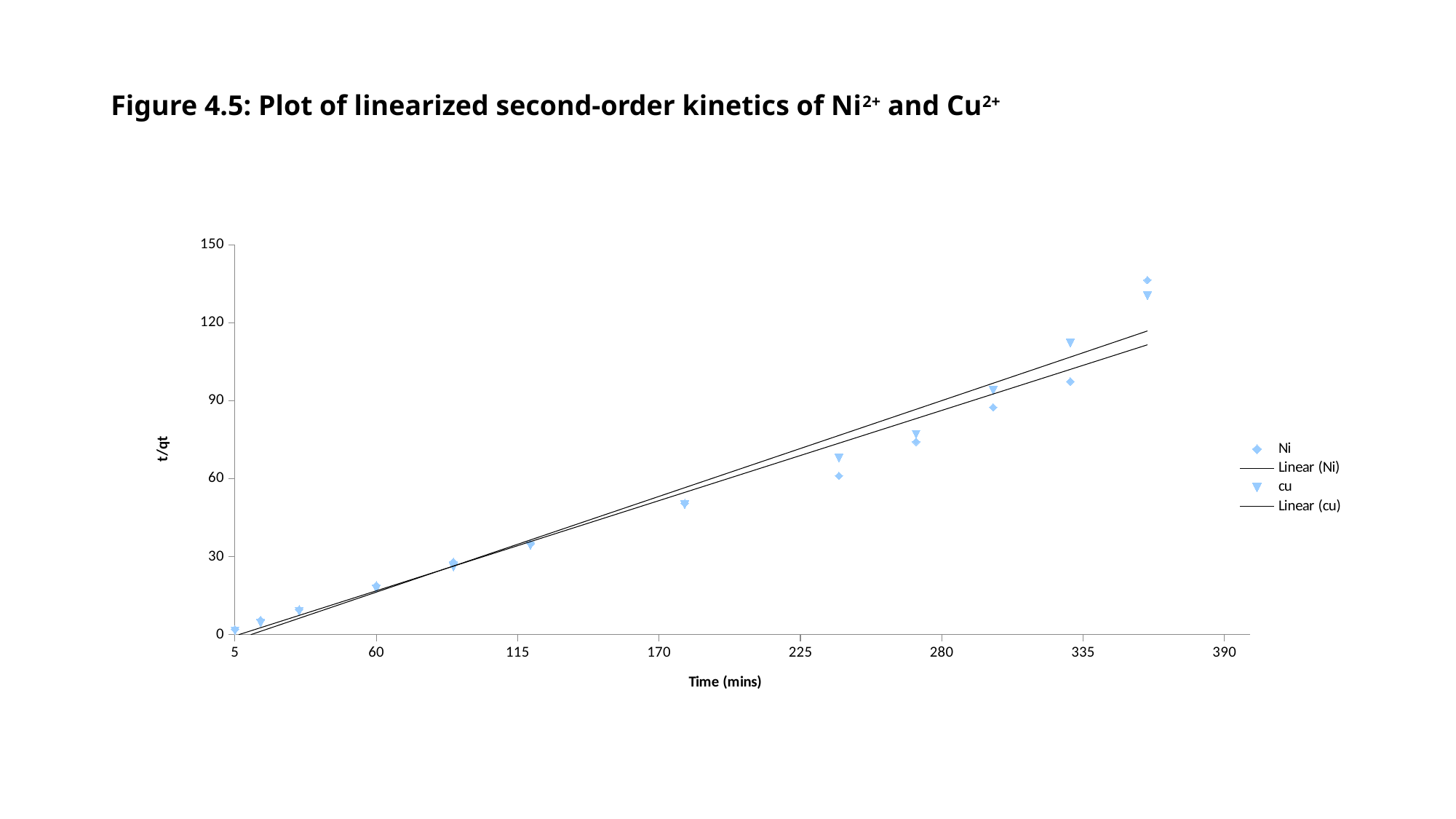
What kind of chart is shown on the slide? Scatter chart Is the cu value at around 240 mins greater or less than 60? greater Is the Ni value at the last time point (around 360 mins) greater or less than 120? greater Is the cu value at around 330 mins greater or less than 120? less What is the title of the chart on the slide? Figure 4.5: Plot of linearized second-order kinetics of Ni2+ and Cu2+ How many entries does the chart legend list? 4 Which series has the highest plotted t/qt value on the chart? Ni Do the t/qt values rise or fall as time increases? Rise At around 330 mins, which series has the larger t/qt value, Ni or cu? cu How many data points are plotted for the Ni series? 12 What is the label of the x axis? Time (mins)